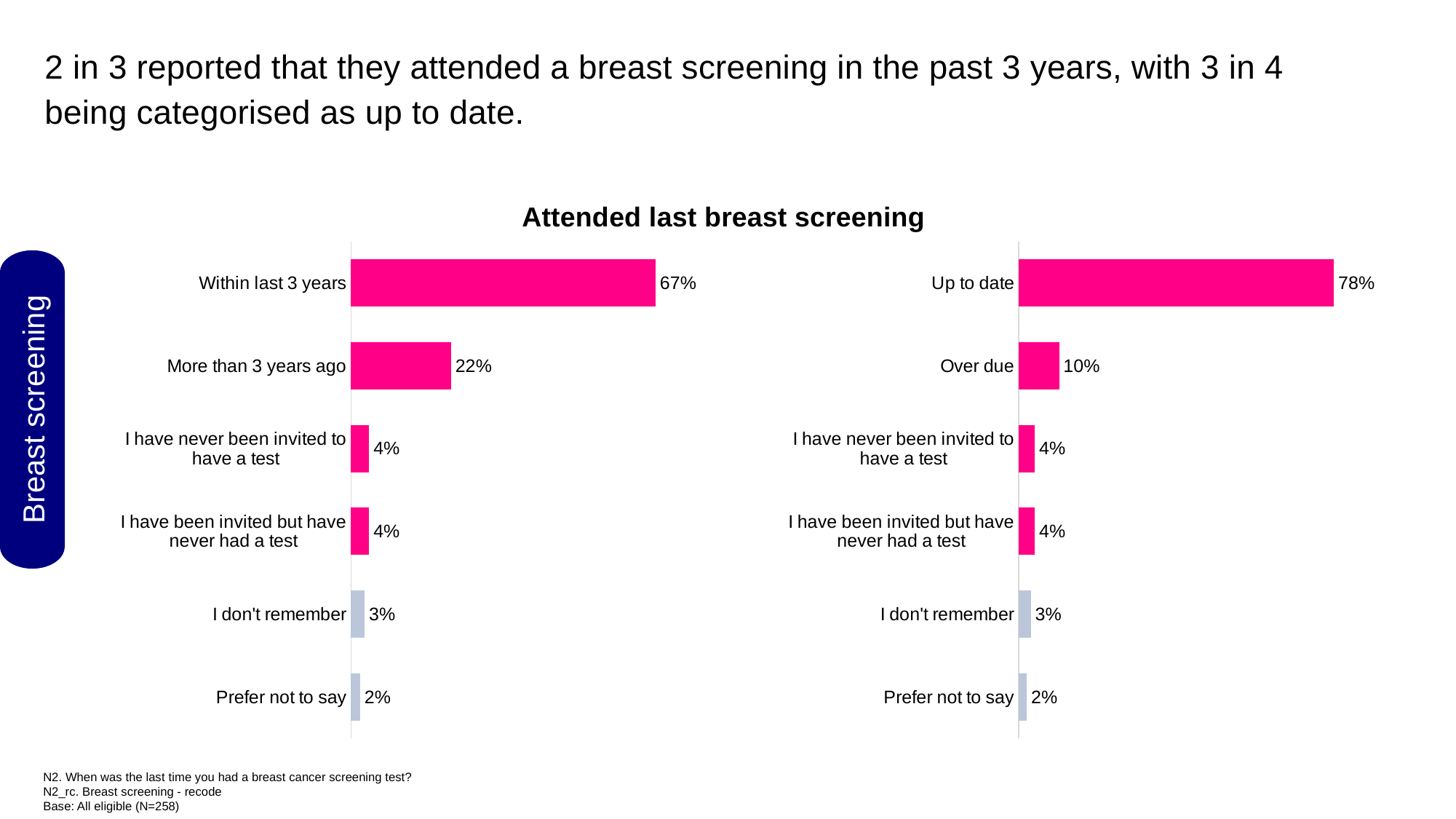
In the right chart, which category has the lowest value? Prefer not to say In the right chart, what is the difference between 'Up to date' and 'Over due'? 68 percentage points In the left chart, what is the difference between 'Within last 3 years' and 'More than 3 years ago'? 45 percentage points In the left chart, what is the value for 'More than 3 years ago'? 22% What type of chart is used on this slide? Bar chart In the right chart, what is the value for 'Over due'? 10% What is the title shown above the charts? Attended last breast screening How many categories are shown in the left chart? 6 In the right chart, what percentage are categorised as up to date? 78% Which is larger: 'Within last 3 years' in the left chart or 'Up to date' in the right chart? Up to date In the left chart, which category has the highest value? Within last 3 years In the left chart, what percentage reported attending a breast screening within the last 3 years? 67%